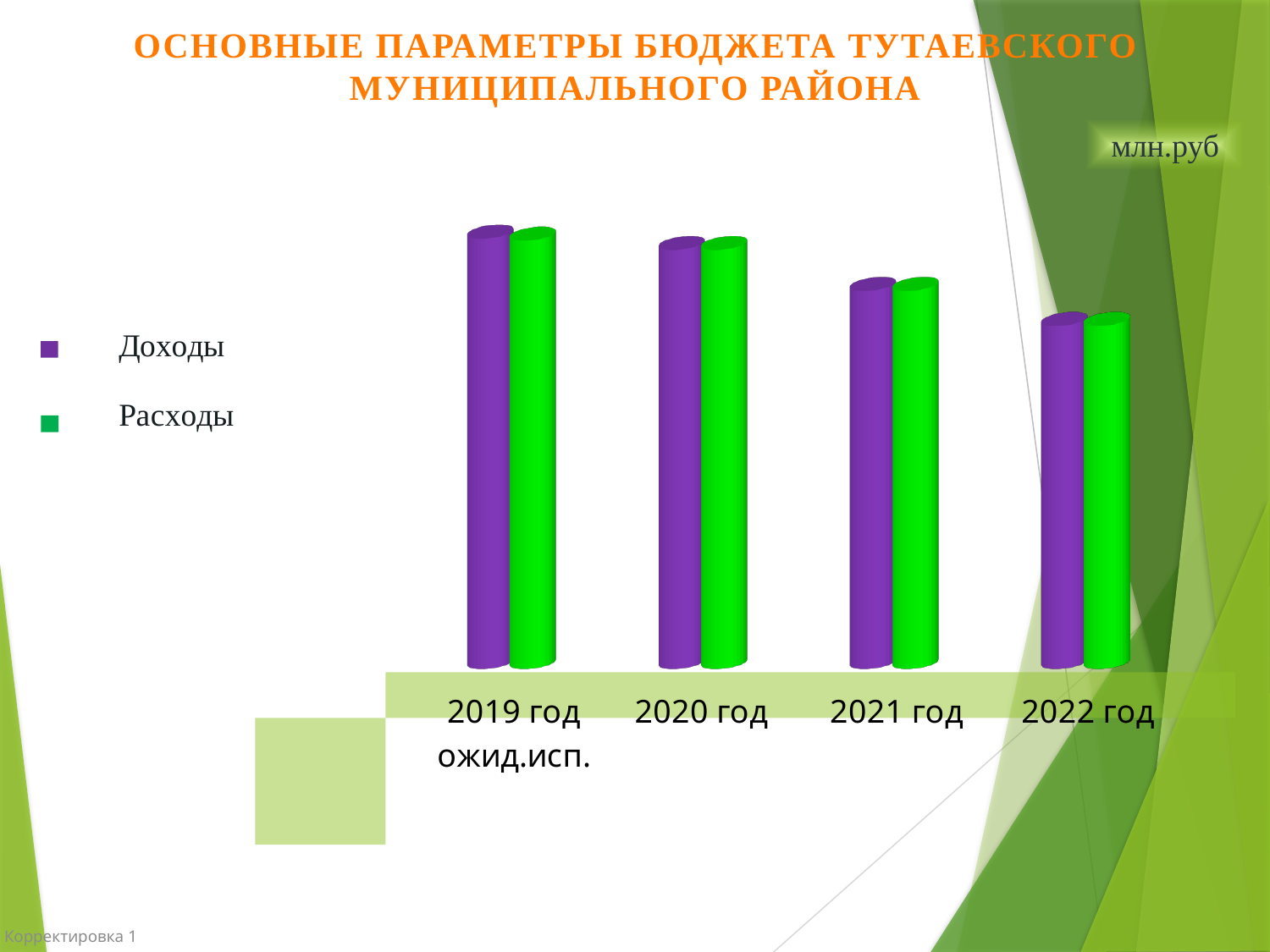
Do the values for Расходы rise or fall from 2019 год to 2022 год? fall What kind of chart is shown on the slide? bar chart How many series does the chart's legend list? 2 Which series is shown in purple in the chart? Доходы Which year has the highest value for Доходы? 2019 год ожид.исп. Which is larger: Расходы in 2020 год or Расходы in 2021 год? 2020 год What unit of measurement is indicated for the chart? млн.руб Which year has the lowest value for Доходы? 2022 год Which is larger: Доходы in 2019 год ожид.исп. or Доходы in 2022 год? 2019 год ожид.исп. How many categories (years) are shown on the x axis of the chart? 4 Do the values for Доходы rise or fall from 2019 год to 2022 год? fall Which year has the lowest value for Расходы? 2022 год